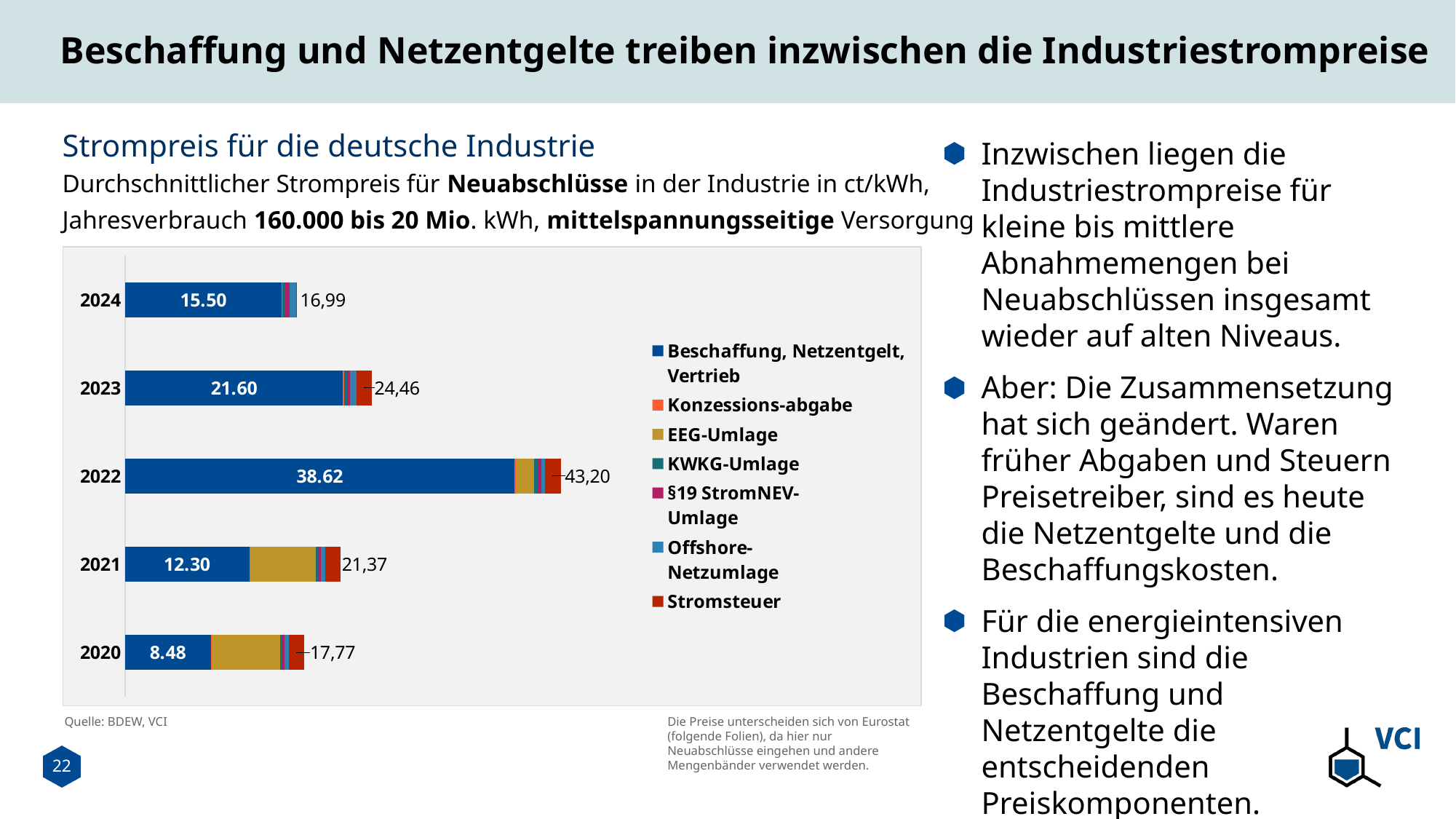
How many series does the legend list? 7 Which year has the larger Beschaffung, Netzentgelt, Vertrieb value, 2020 or 2021? 2021 What is the total electricity price shown for 2024? 16,99 Which year has the highest total electricity price? 2022 What is the value of the Beschaffung, Netzentgelt, Vertrieb segment for 2021? 12.30 What is the total electricity price shown for 2020? 17,77 What is the value of the Beschaffung, Netzentgelt, Vertrieb segment for 2022? 38.62 What kind of chart is shown on the slide? Stacked bar chart How many years are shown in the chart? 5 Which year has the lowest total electricity price? 2024 Which series is shown in dark blue in the chart? Beschaffung, Netzentgelt, Vertrieb What is the difference between the Beschaffung, Netzentgelt, Vertrieb values for 2023 and 2024? 6.10